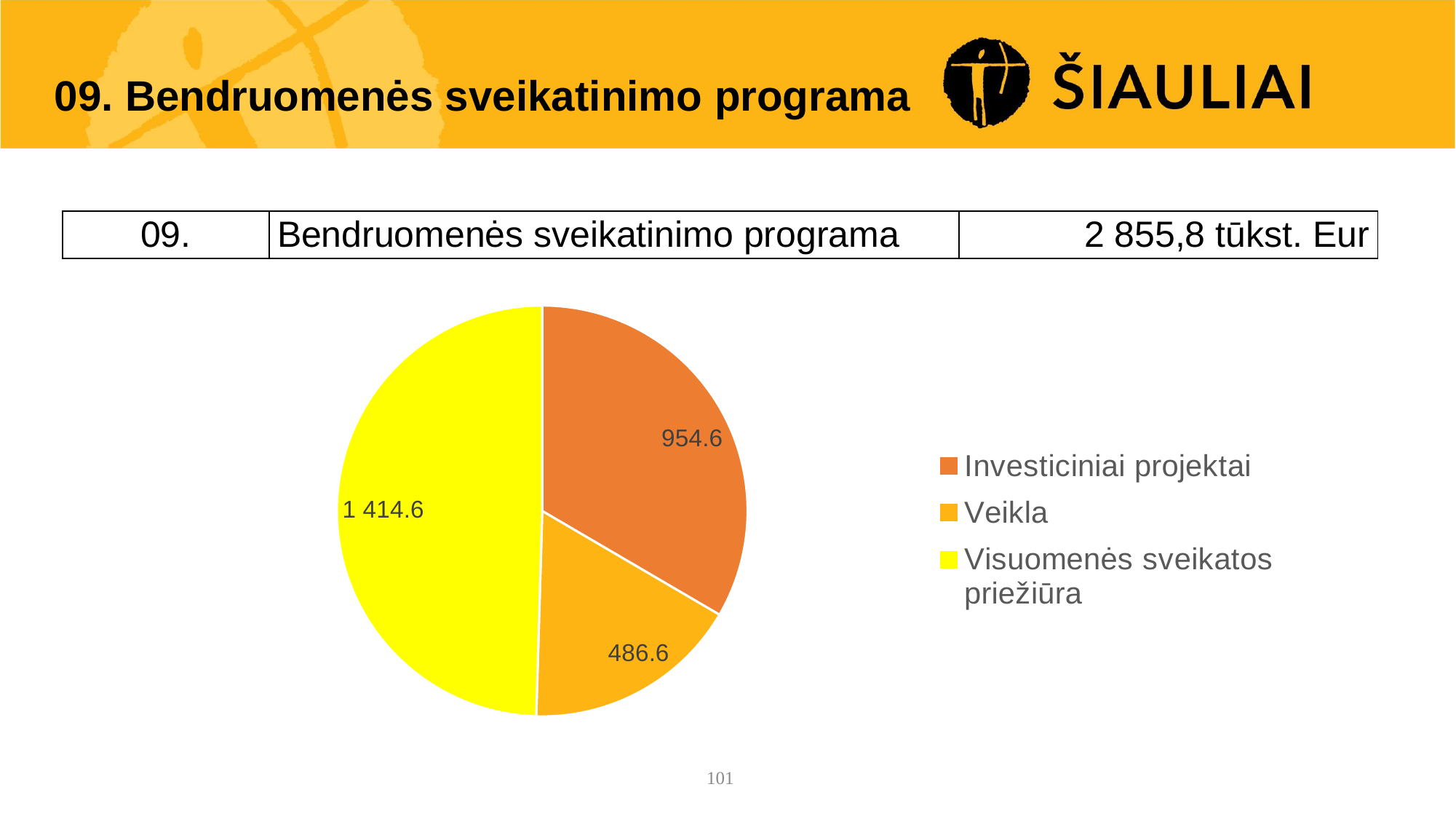
What is the value for Visuomenės sveikatos priežiūra in the pie chart? 1 414.6 What type of chart is shown on the slide? pie chart What is the value for Veikla in the pie chart? 486.6 What is the value for Investiciniai projektai in the pie chart? 954.6 What colour is the slice for Veikla in the pie chart? orange How many slices does the pie chart have? 3 Which category has the smallest slice in the pie chart? Veikla What is the difference between the values for Visuomenės sveikatos priežiūra and Investiciniai projektai? 460.0 What share of the pie does Visuomenės sveikatos priežiūra represent? 49.5% What is the difference between the values for Investiciniai projektai and Veikla? 468.0 Which category has the largest slice in the pie chart? Visuomenės sveikatos priežiūra Which is larger, the value for Investiciniai projektai or the value for Veikla? Investiciniai projektai